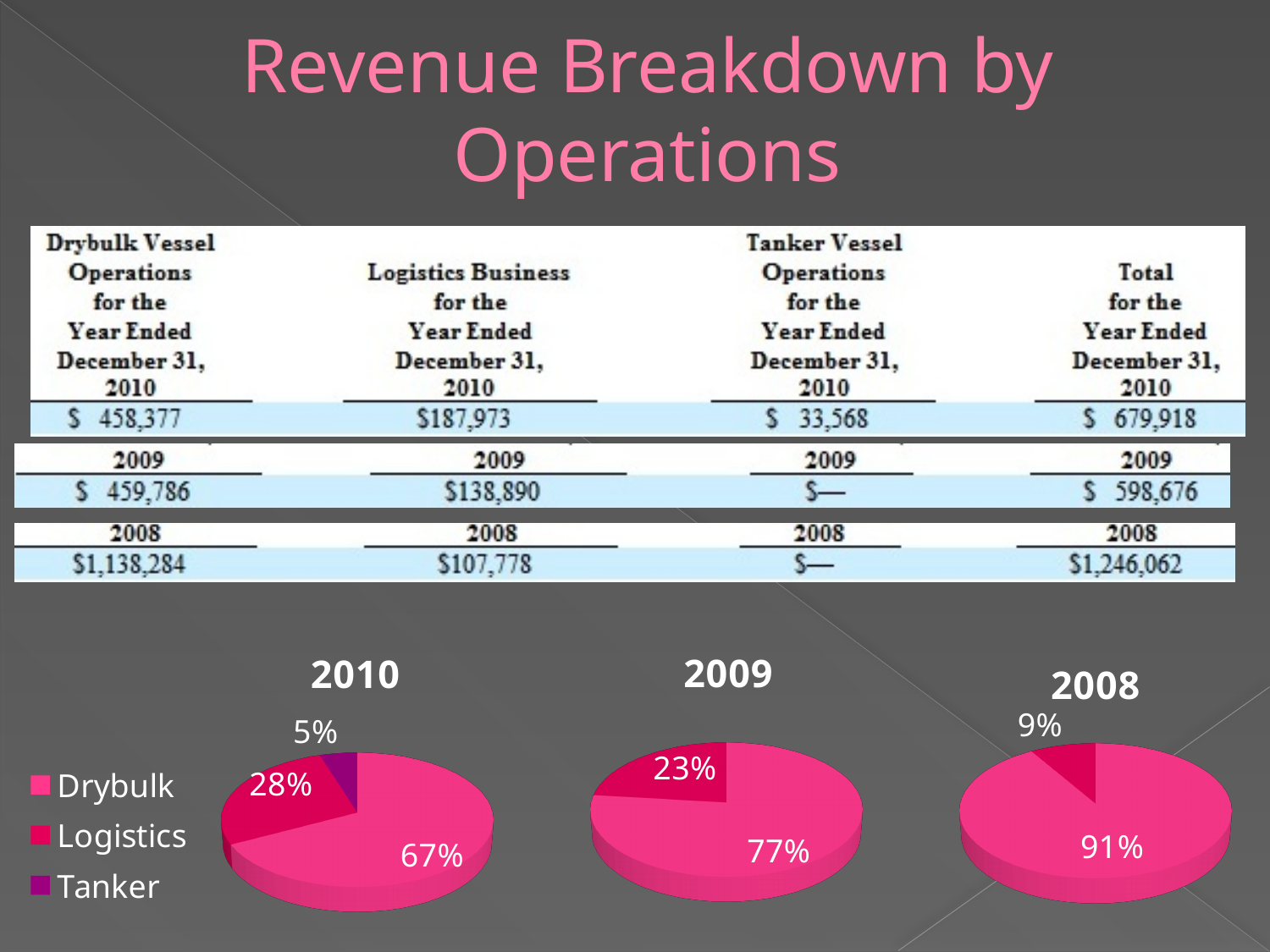
In the 2008 pie chart, what share of revenue does Logistics account for? 9% In the 2009 pie chart, what share of revenue does Drybulk account for? 77% In the 2010 pie chart, what share of revenue does Logistics account for? 28% In the 2010 pie chart, what is the difference in percentage points between the Drybulk share and the Logistics share? 39 percentage points What kind of charts are shown at the bottom of the slide? Pie charts How many entries does the legend for the pie charts list? 3 In the 2008 pie chart, which segment has the largest share? Drybulk In the 2010 pie chart, which segment has the smallest share? Tanker